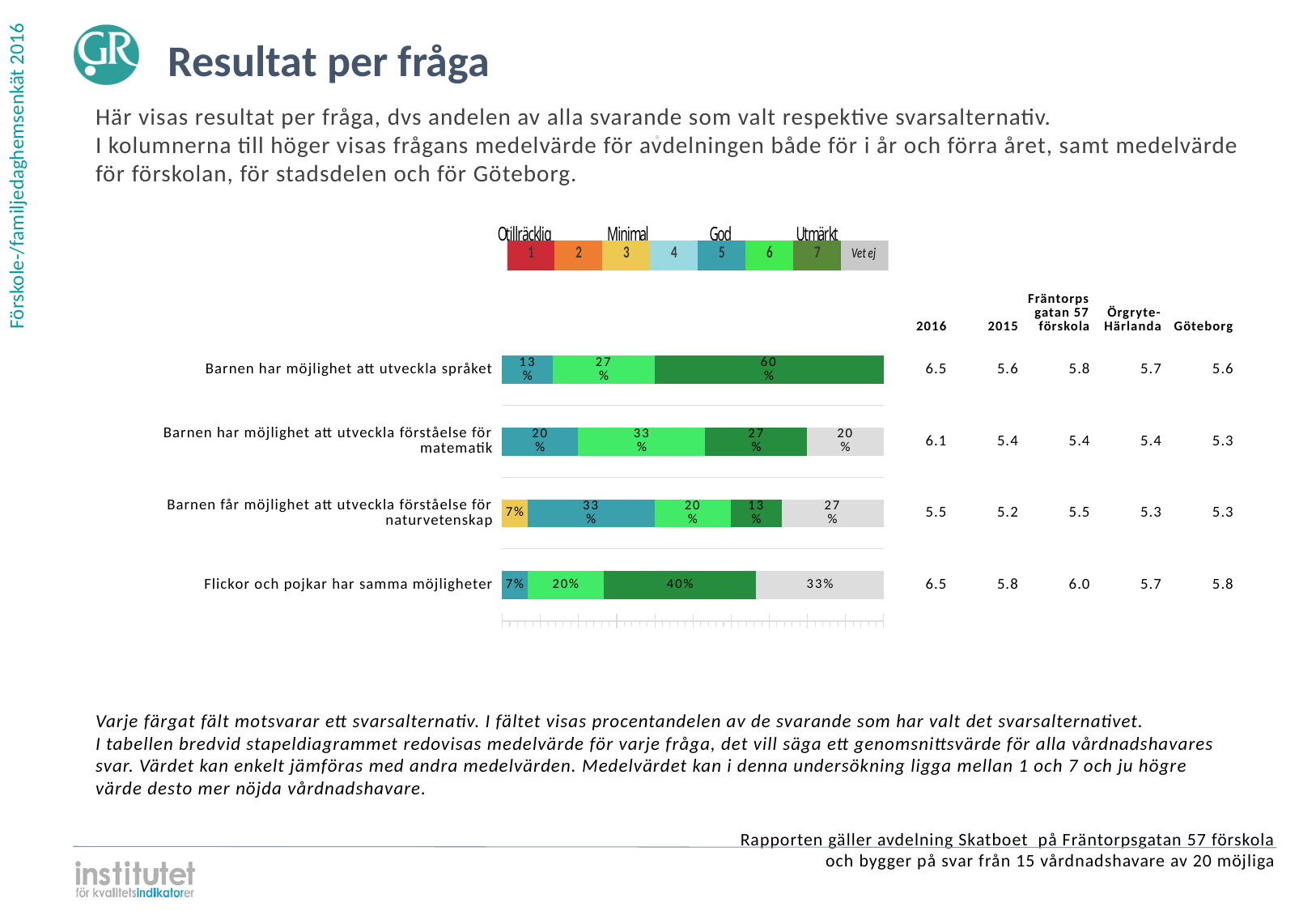
What percentage of respondents answered 'Vet ej' for 'Flickor och pojkar har samma möjligheter'? 33% How many response options does the legend above the chart list, including 'Vet ej'? 8 How many questions (categories) are shown as bars in the chart? 4 Which is larger: the 'Vet ej' share for 'Barnen har möjlighet att utveckla förståelse för matematik' or for 'Barnen får möjlighet att utveckla förståelse för naturvetenskap'? Barnen får möjlighet att utveckla förståelse för naturvetenskap What is the Göteborg mean value shown for 'Flickor och pojkar har samma möjligheter'? 5.8 Which question has the largest share of respondents choosing option 7 (dark green)? Barnen har möjlighet att utveckla språket What is the total of the three labelled segments in the bar for 'Barnen har möjlighet att utveckla språket'? 100% What is the difference between the option 6 (light green) share for 'Barnen har möjlighet att utveckla förståelse för matematik' and for 'Flickor och pojkar har samma möjligheter'? 13 percentage points What percentage of respondents chose option 3 (yellow) for 'Barnen får möjlighet att utveckla förståelse för naturvetenskap'? 7% What percentage of respondents chose option 7 (dark green) for 'Barnen har möjlighet att utveckla språket'? 60% What kind of chart is used to show the results per question? Stacked bar chart What is the 2016 mean value shown for 'Barnen har möjlighet att utveckla förståelse för matematik'? 6.1